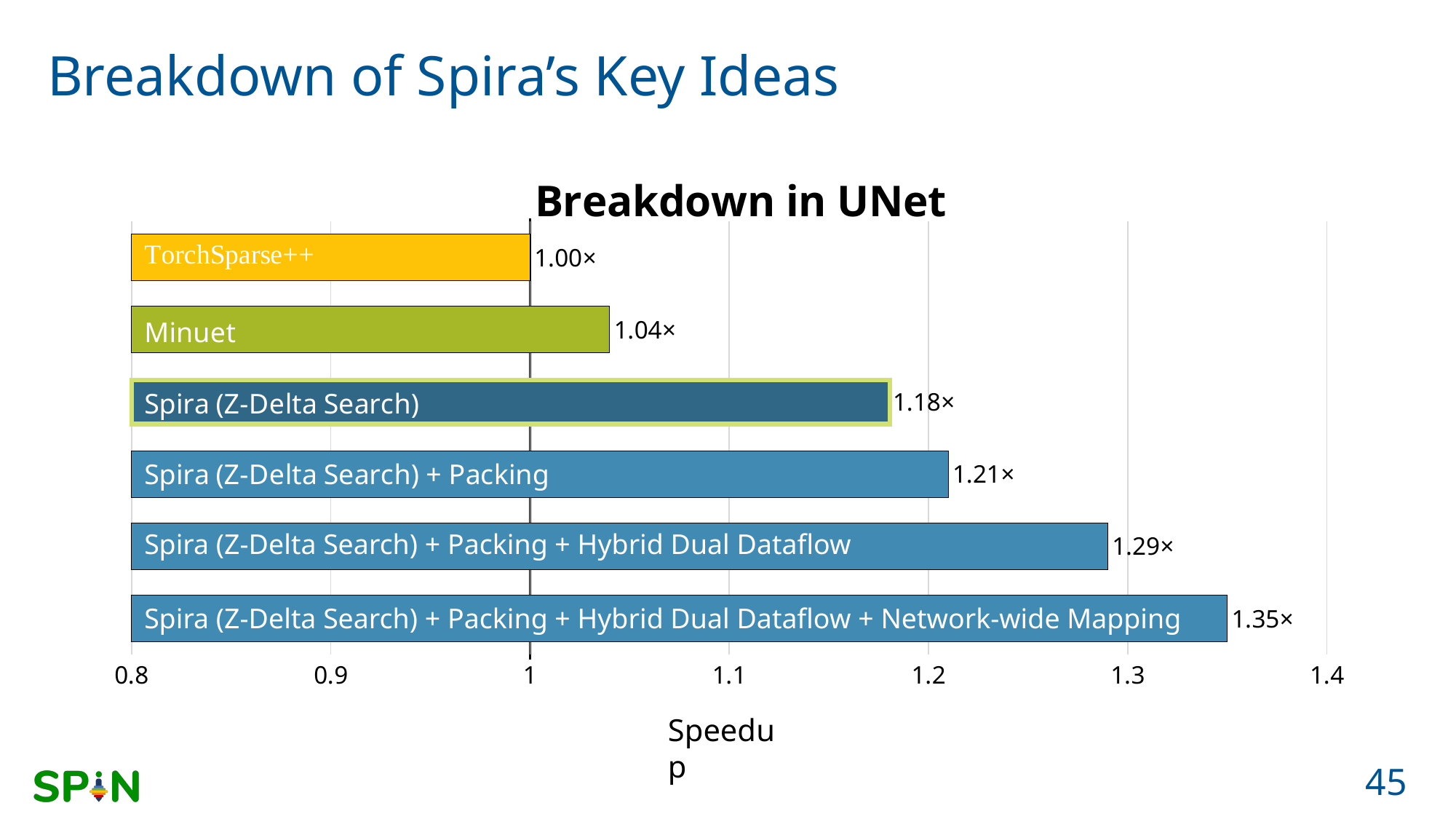
Which has a larger speedup, Minuet or Spira (Z-Delta Search)? Spira (Z-Delta Search) Which configuration has the lowest speedup? TorchSparse++ What is the title of the chart? Breakdown in UNet What is the speedup for Spira (Z-Delta Search) + Packing? 1.21× What is the label of the x axis? Speedup What kind of chart is shown on the slide? Bar chart Is the speedup for Spira (Z-Delta Search) + Packing + Hybrid Dual Dataflow greater or less than 1.2? greater What is the speedup for Minuet? 1.04× How many configurations are shown in the chart? 6 What is the speedup for Spira (Z-Delta Search) + Packing + Hybrid Dual Dataflow + Network-wide Mapping? 1.35× Which configuration has the highest speedup? Spira (Z-Delta Search) + Packing + Hybrid Dual Dataflow + Network-wide Mapping What is the difference in speedup between Spira (Z-Delta Search) + Packing + Hybrid Dual Dataflow and Spira (Z-Delta Search)? 0.11×